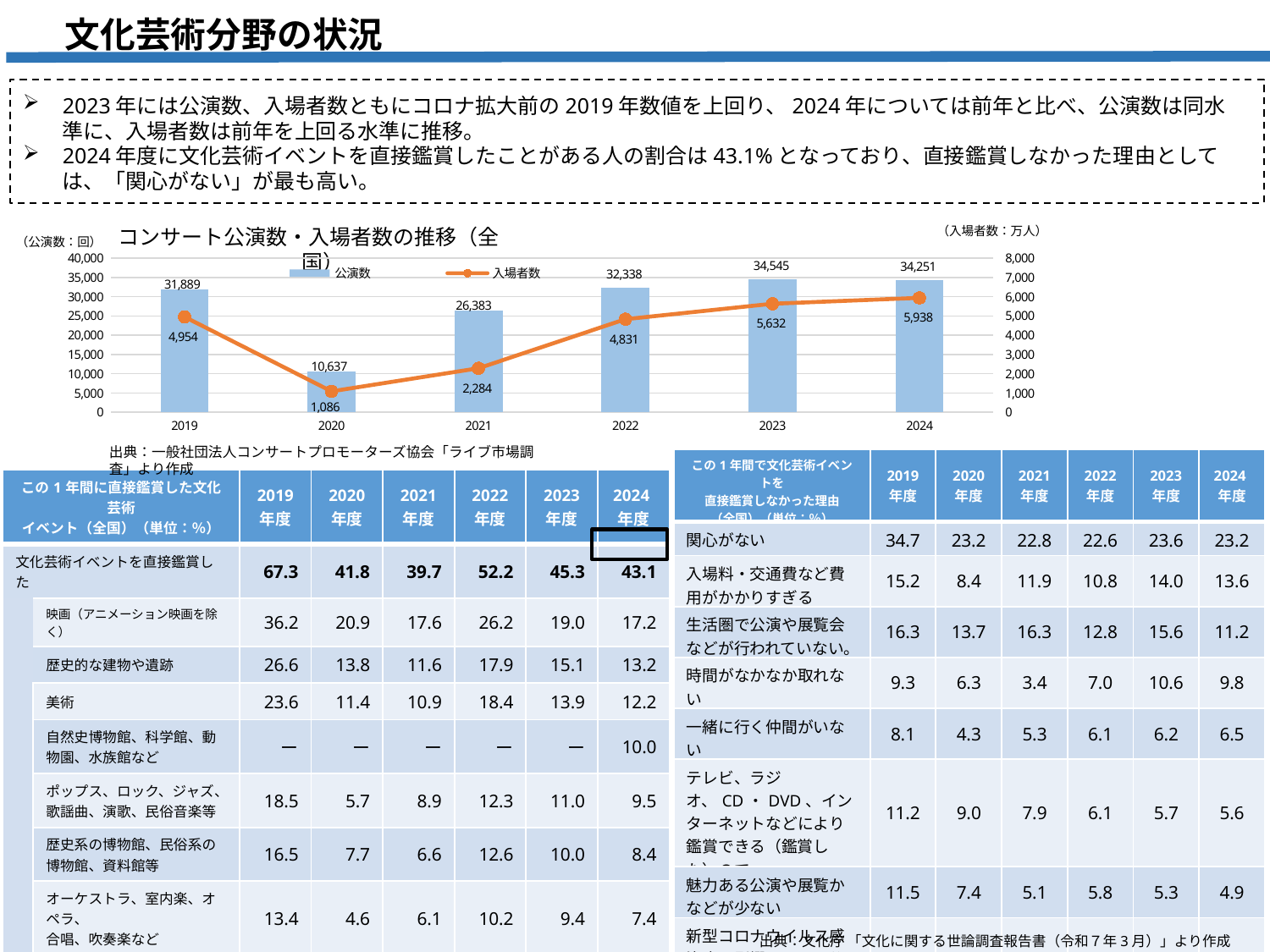
「コンサート公演数・入場者数の推移（全国）」のグラフで、2020年から2023年にかけて入場者数は増加していますか、減少していますか？ 増加 「コンサート公演数・入場者数の推移（全国）」のグラフで、2019年と2020年の公演数の差はいくつですか？ 21,252 「コンサート公演数・入場者数の推移（全国）」のグラフで、2021年の公演数は30,000より多いですか、少ないですか？ 少ない 「コンサート公演数・入場者数の推移（全国）」のグラフで、2020年の入場者数はいくつですか？ 1,086 「コンサート公演数・入場者数の推移（全国）」のグラフで、公演数が最も多い年はどれですか？ 2023 「コンサート公演数・入場者数の推移（全国）」のグラフで、2023年の公演数はいくつですか？ 34,545 「コンサート公演数・入場者数の推移（全国）」のグラフの凡例には系列がいくつありますか？ 2 「コンサート公演数・入場者数の推移（全国）」のグラフで、2024年の入場者数は2023年より多いですか、少ないですか？ 多い 「コンサート公演数・入場者数の推移（全国）」のグラフで、2024年の入場者数はいくつですか？ 5,938 「コンサート公演数・入場者数の推移（全国）」のグラフで、入場者数はどのような形式で表示されていますか？ 折れ線 「コンサート公演数・入場者数の推移（全国）」のグラフには何年分のデータがありますか？ 6 「コンサート公演数・入場者数の推移（全国）」のグラフで、入場者数が最も少ない年はどれですか？ 2020